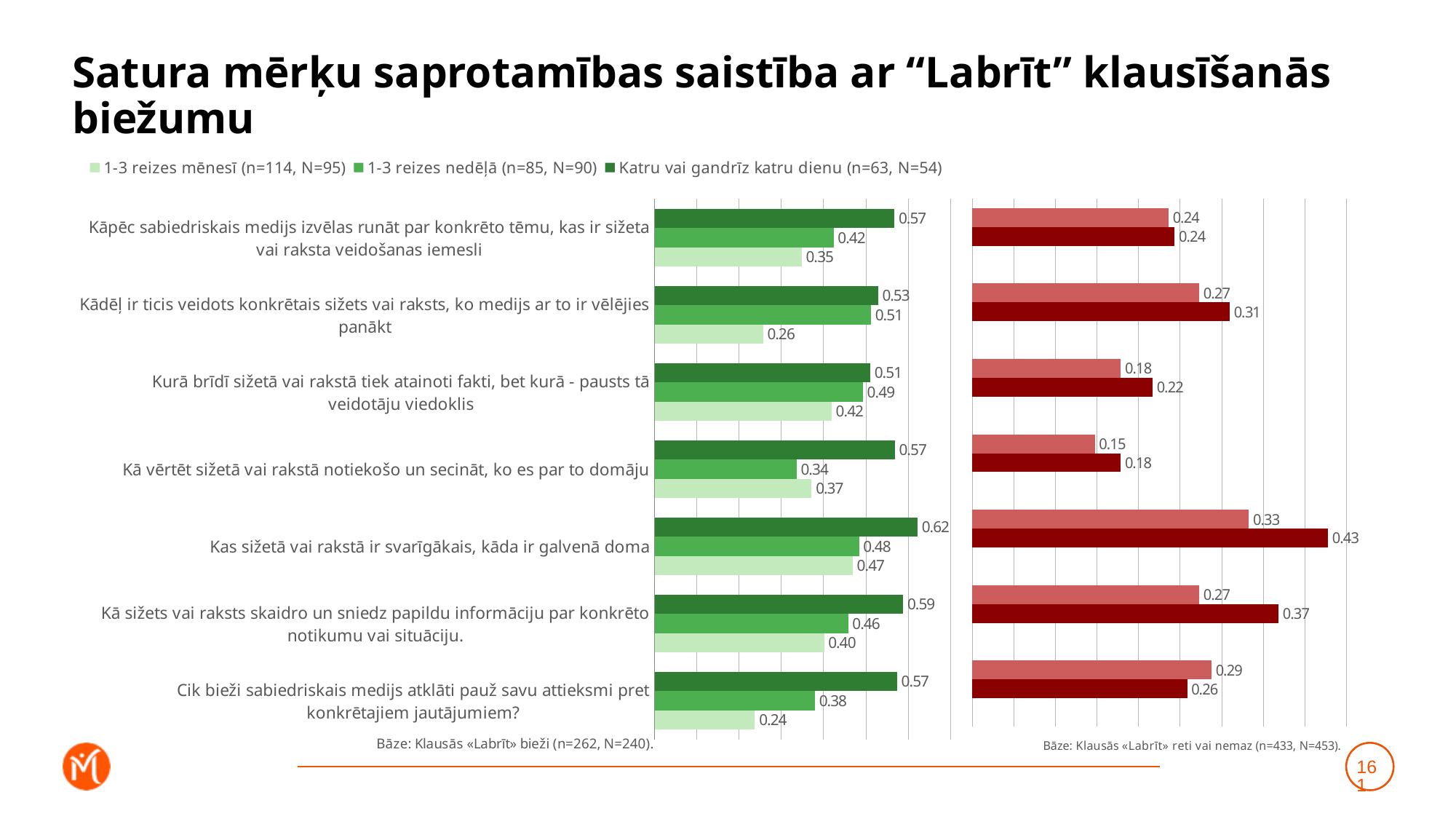
In the left-hand (green) chart, for 'Kā vērtēt sižetā vai rakstā notiekošo un secināt, ko es par to domāju', which is larger: the '1-3 reizes mēnesī' value or the '1-3 reizes nedēļā' value? 1-3 reizes mēnesī In the left-hand (green) chart, which series is shown in the darkest green? Katru vai gandrīz katru dienu (n=63, N=54) In the left-hand (green) chart, what is the value for '1-3 reizes nedēļā' for 'Cik bieži sabiedriskais medijs atklāti pauž savu attieksmi pret konkrētajiem jautājumiem?'? 0.38 In the left-hand (green) chart, what is the value for '1-3 reizes mēnesī' for 'Kādēļ ir ticis veidots konkrētais sižets vai raksts, ko medijs ar to ir vēlējies panākt'? 0.26 In the left-hand (green) chart, which category has the lowest value for '1-3 reizes mēnesī'? Cik bieži sabiedriskais medijs atklāti pauž savu attieksmi pret konkrētajiem jautājumiem? How many categories are shown in the left-hand (green) chart? 7 In the left-hand (green) chart, which category has the highest value for 'Katru vai gandrīz katru dienu'? Kas sižetā vai rakstā ir svarīgākais, kāda ir galvenā doma How many series does the legend of the left-hand (green) chart list? 3 In the left-hand (green) chart, what is the value for 'Katru vai gandrīz katru dienu' for 'Kas sižetā vai rakstā ir svarīgākais, kāda ir galvenā doma'? 0.62 What type of chart is the left-hand (green) chart? Bar chart In the left-hand (green) chart, what is the difference between the 'Katru vai gandrīz katru dienu' and '1-3 reizes mēnesī' values for 'Cik bieži sabiedriskais medijs atklāti pauž savu attieksmi pret konkrētajiem jautājumiem?'? 0.33 In the right-hand (red) chart, what is the highest value shown? 0.43